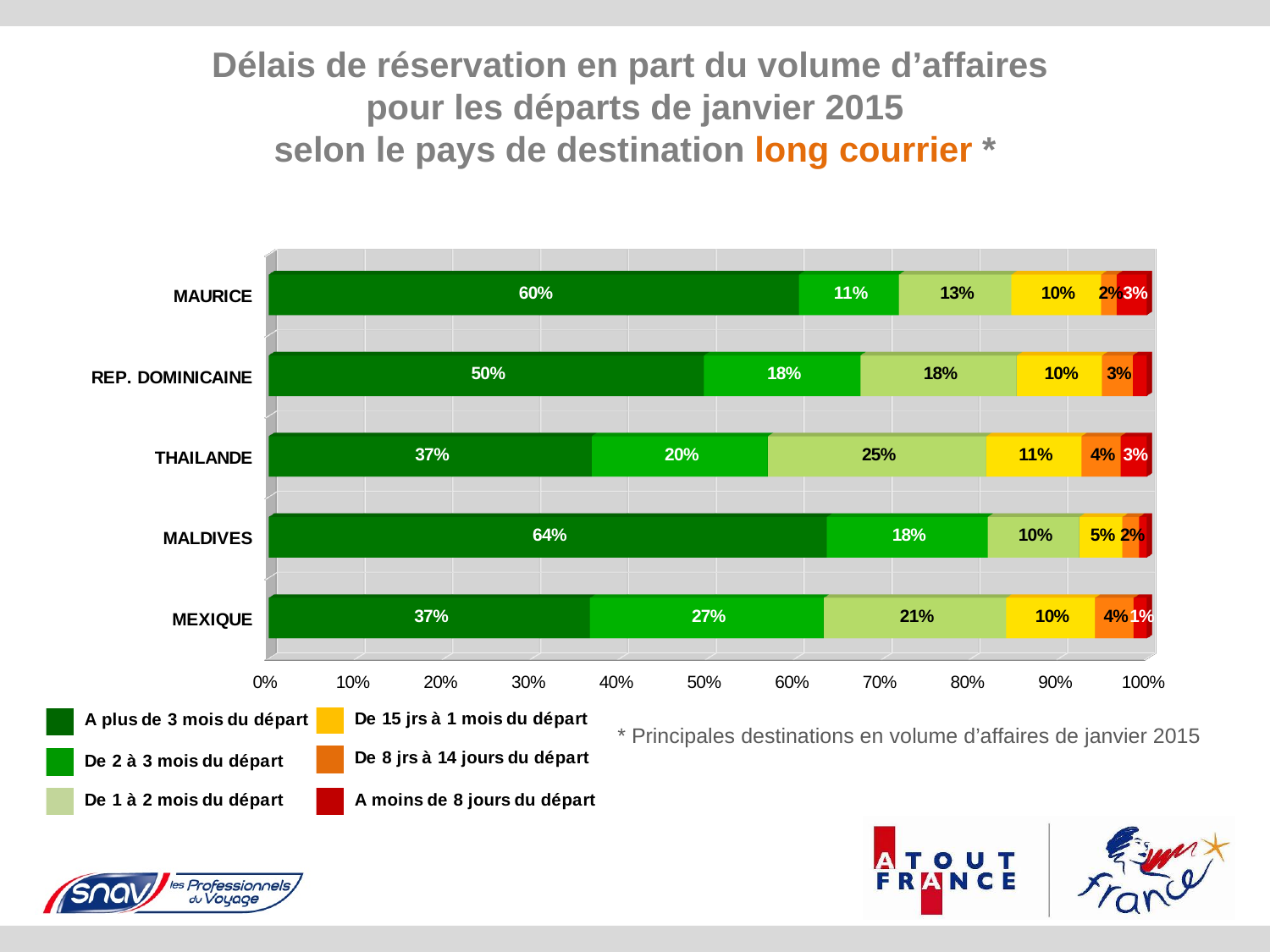
What is the value for 'De 15 jrs à 1 mois du départ' for MALDIVES? 5% Which country has the lowest value for 'De 2 à 3 mois du départ'? MAURICE What kind of chart is shown on the slide? Stacked bar chart Which legend entry is shown in red? A moins de 8 jours du départ What is the value for 'De 1 à 2 mois du départ' for THAILANDE? 25% How many countries are shown on the chart? 5 What is the value for 'A plus de 3 mois du départ' for MAURICE? 60% Which is larger: the 'De 1 à 2 mois du départ' value for REP. DOMINICAINE or for MEXIQUE? MEXIQUE What is the value for 'De 2 à 3 mois du départ' for MEXIQUE? 27% What is the difference between the 'A plus de 3 mois du départ' values for MALDIVES and REP. DOMINICAINE? 14% Which country has the highest value for 'A plus de 3 mois du départ'? MALDIVES How many series does the legend list? 6